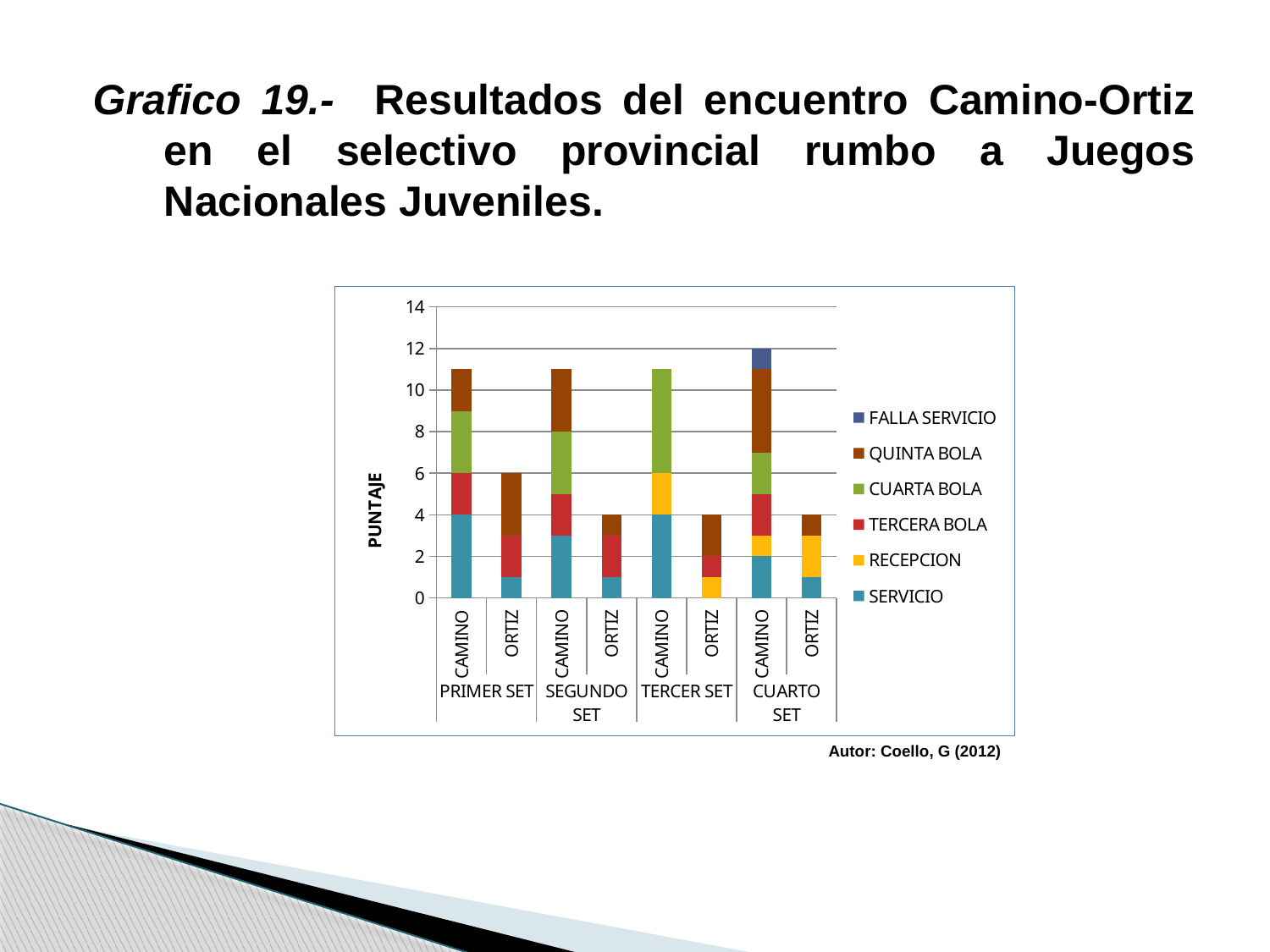
Is the total for CAMINO in PRIMER SET greater or less than 10? greater What is the total score for CAMINO in CUARTO SET? 12 How many series does the legend list? 6 Which is larger, the total for ORTIZ in PRIMER SET or the total for ORTIZ in SEGUNDO SET? ORTIZ in PRIMER SET Which bar reaches the highest total score? CAMINO in CUARTO SET What is the SERVICIO value for CAMINO in PRIMER SET? 4 In PRIMER SET, who has the higher total, CAMINO or ORTIZ? CAMINO What kind of chart is shown on the slide? bar chart What is the total score for ORTIZ in PRIMER SET? 6 Is the total for ORTIZ in SEGUNDO SET greater or less than 6? less How many bars are plotted in the chart? 8 What is the title of the vertical axis? PUNTAJE